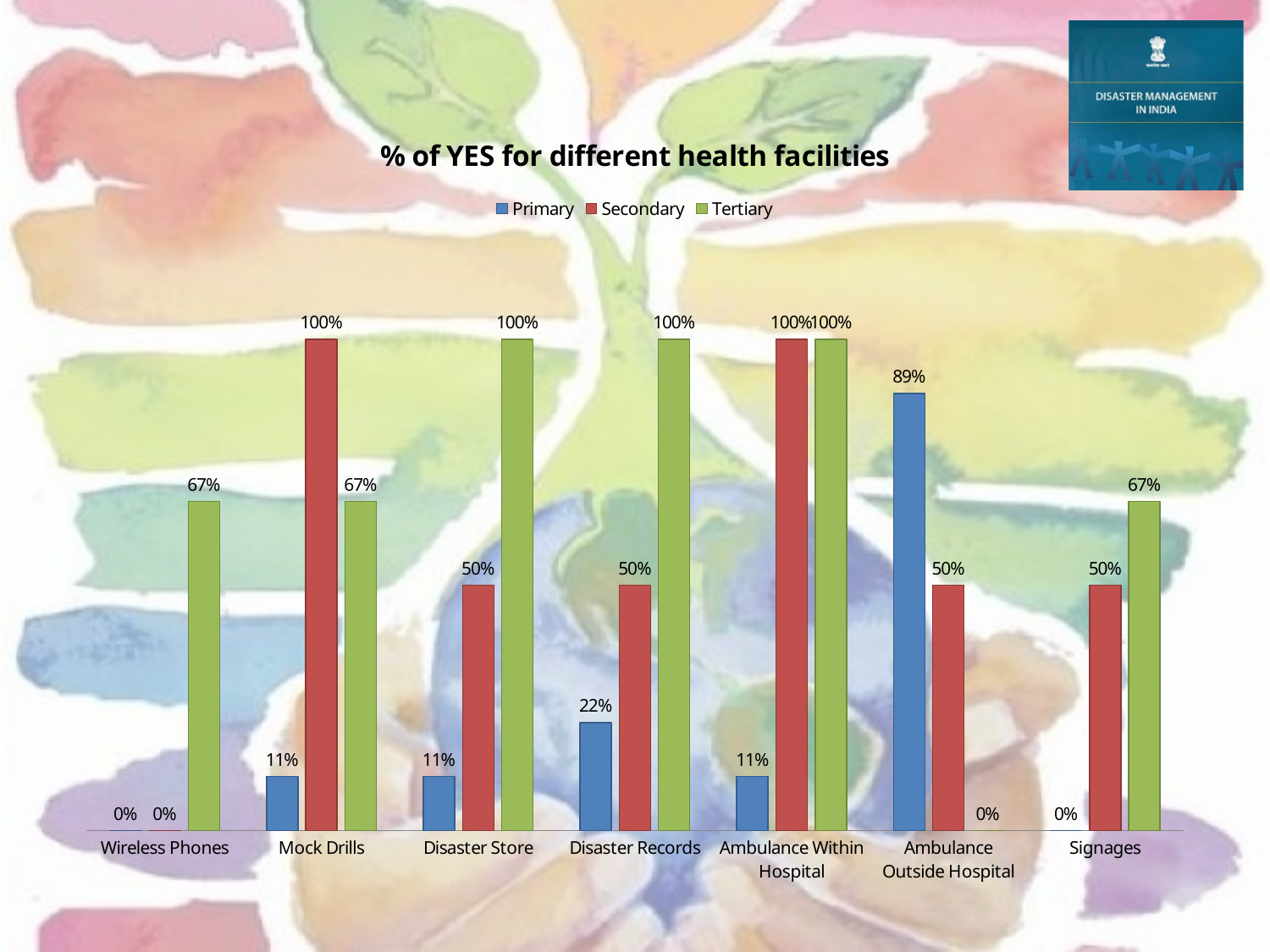
Which category has the lowest Tertiary value? Ambulance Outside Hospital What is the Primary value for Ambulance Outside Hospital? 89% What kind of chart is shown on the slide? Bar chart How many categories are shown on the x axis? 7 Which is larger for Disaster Store: the Secondary value or the Tertiary value? Tertiary How many series does the legend list? 3 What is the difference between the Tertiary and Primary values for Wireless Phones? 67% What is the Secondary value for Mock Drills? 100% Which category has the highest Primary value? Ambulance Outside Hospital What is the title of the chart? % of YES for different health facilities What is the Primary value for Disaster Records? 22% What is the Tertiary value for Signages? 67%